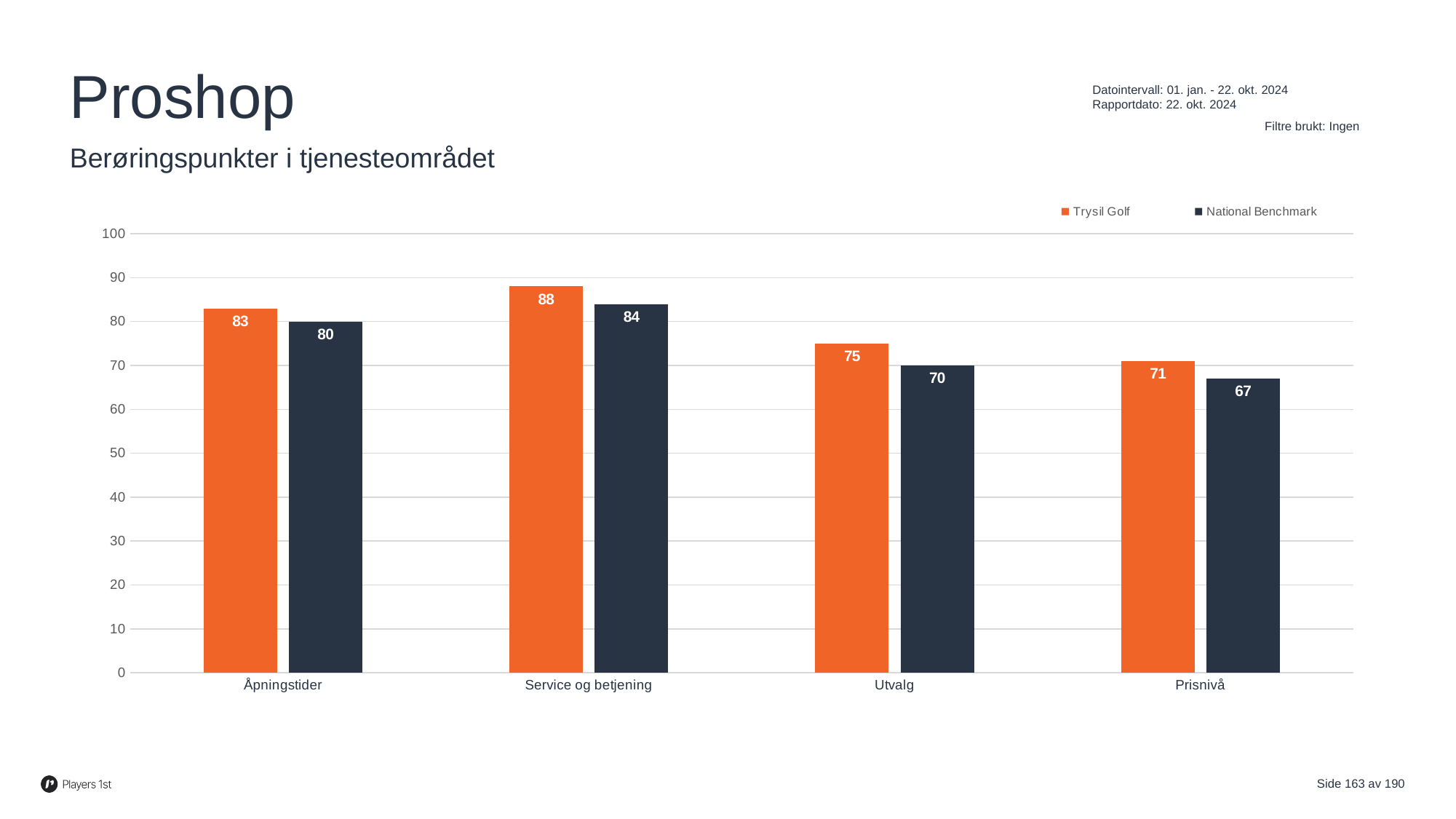
What is the Trysil Golf value for Utvalg? 75 How many series does the legend list? 2 Which is larger for Åpningstider: Trysil Golf or National Benchmark? Trysil Golf What is the difference between the Trysil Golf and National Benchmark values for Utvalg? 5 Is the National Benchmark value for Åpningstider greater or less than 70? greater Which category has the highest Trysil Golf value? Service og betjening What is the National Benchmark value for Prisnivå? 67 What is the difference between the Trysil Golf values for Service og betjening and Prisnivå? 17 What kind of chart is shown on the slide? Bar chart What is the Trysil Golf value for Service og betjening? 88 Which category has the lowest National Benchmark value? Prisnivå How many categories are shown on the x axis? 4